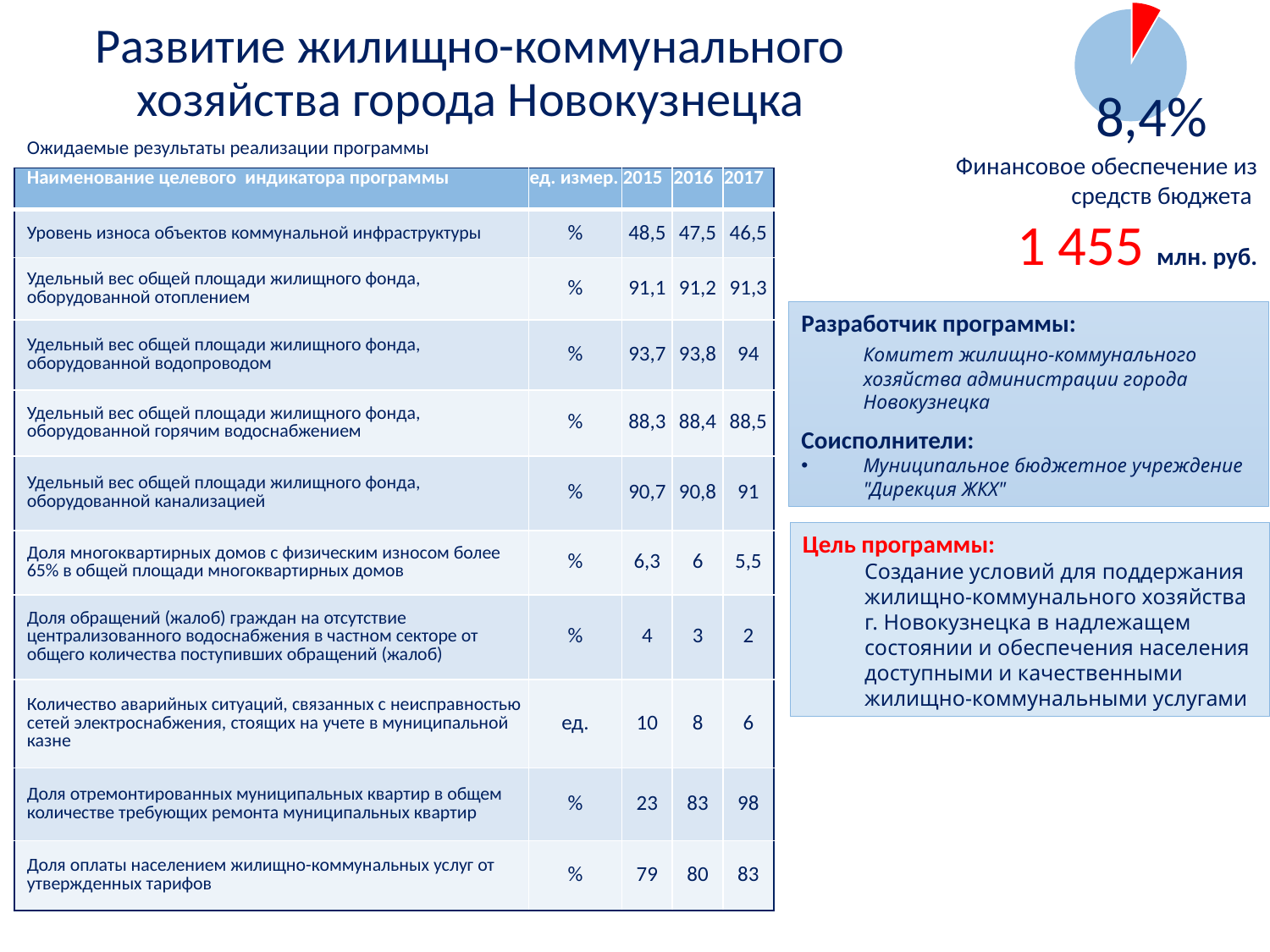
What colour is the slice of the pie chart labelled 8,4%? red What is the only percentage value printed on the pie chart? 8,4% How many slices does the pie chart have? 2 Which slice of the pie chart is larger, the red one or the light blue one? the light blue one What kind of chart is shown in the top right corner of the slide? pie chart Is the share of the red slice in the pie chart greater or less than 50%? less What share of the pie chart does the red slice represent? 8,4% Which slice of the pie chart is the smallest? the red slice